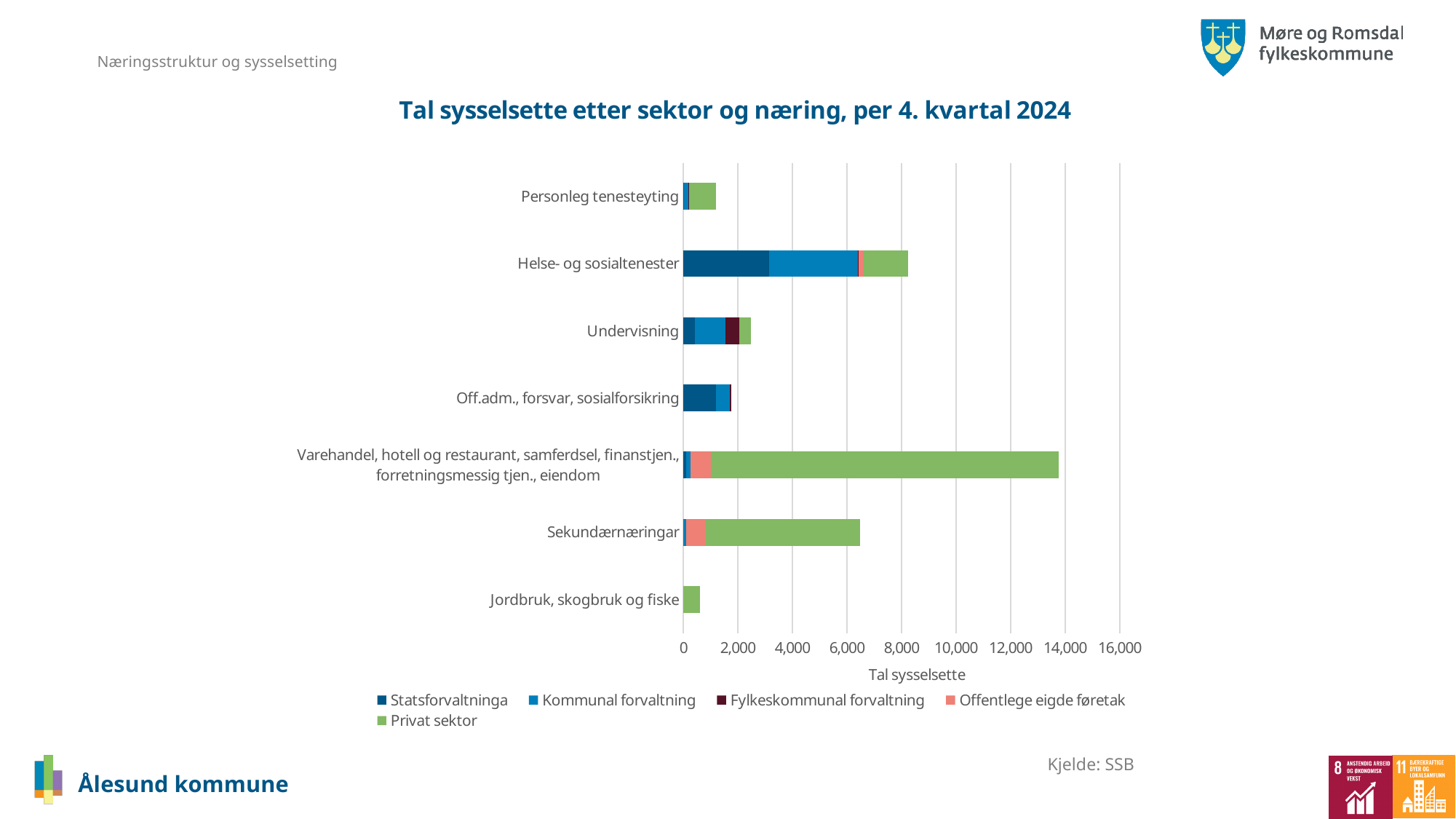
Is the total value for Varehandel, hotell og restaurant, samferdsel, finanstjen., forretningsmessig tjen., eiendom greater or less than 12,000? greater What is the title of the chart? Tal sysselsette etter sektor og næring, per 4. kvartal 2024 Is the total value for Undervisning greater or less than 2,000? greater Is the total value for Sekundærnæringar greater or less than 6,000? greater Which has the larger total bar, Helse- og sosialtenester or Sekundærnæringar? Helse- og sosialtenester What is the label on the horizontal axis of the chart? Tal sysselsette Which category has the longest total bar? Varehandel, hotell og restaurant, samferdsel, finanstjen., forretningsmessig tjen., eiendom How many categories (næringar) are plotted on the chart? 7 How many series does the legend list? 5 What kind of chart is shown on the slide? Stacked bar chart Which category has the shortest total bar? Jordbruk, skogbruk og fiske